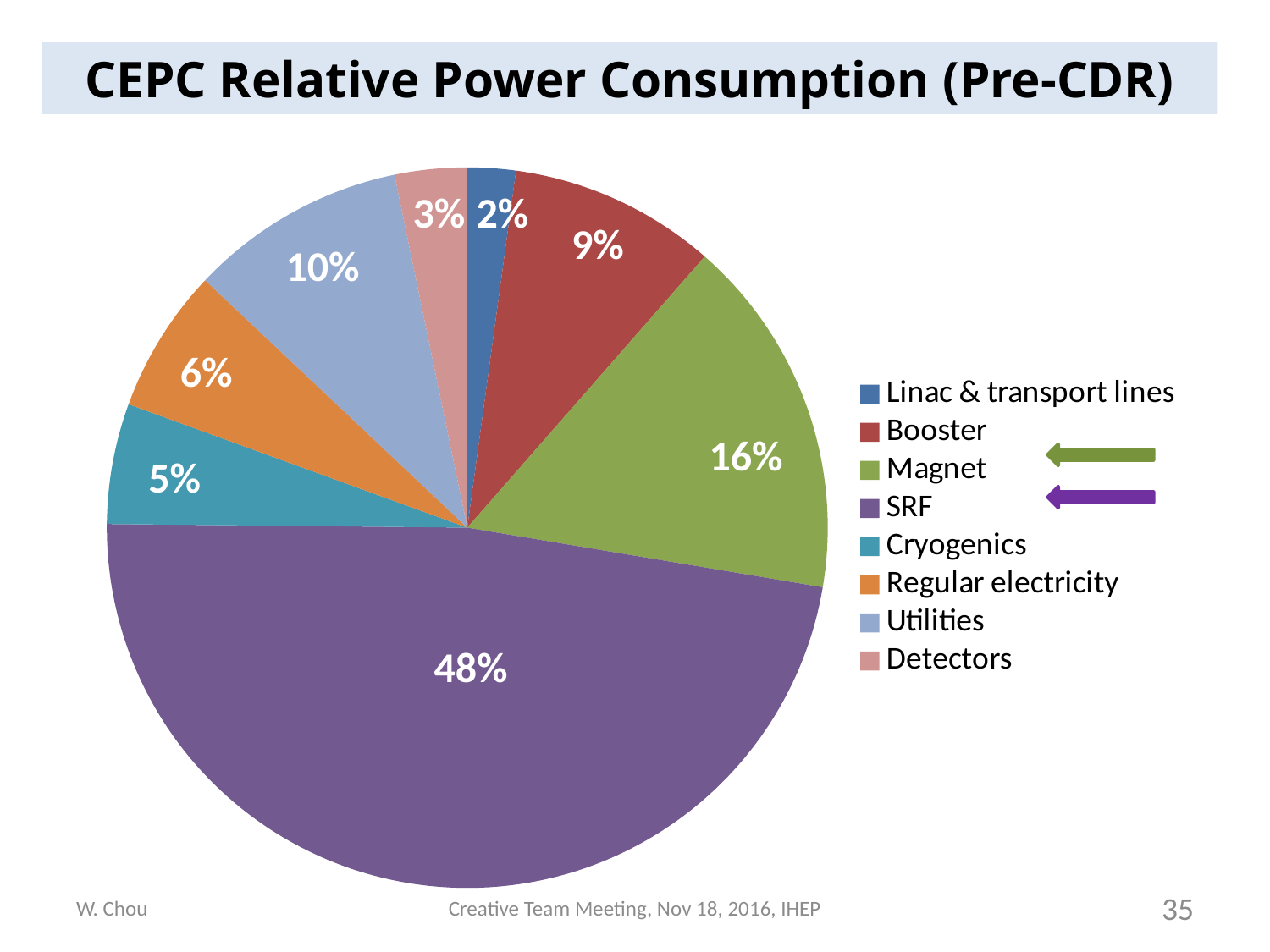
What percentage is shown for Magnet? 16% How many categories does the pie chart show? 8 Which category has the largest share of the pie? SRF Which category has the smallest share of the pie? Linac & transport lines What is the combined share of Booster and Detectors? 12% Which has a larger share, Booster or Regular electricity? Booster What is the difference in percentage points between SRF and Magnet? 32 What share of power consumption does SRF account for? 48% What percentage is shown for Cryogenics? 5% What is the value for Utilities? 10% What is the title of the chart? CEPC Relative Power Consumption (Pre-CDR) What kind of chart is shown on the slide? Pie chart